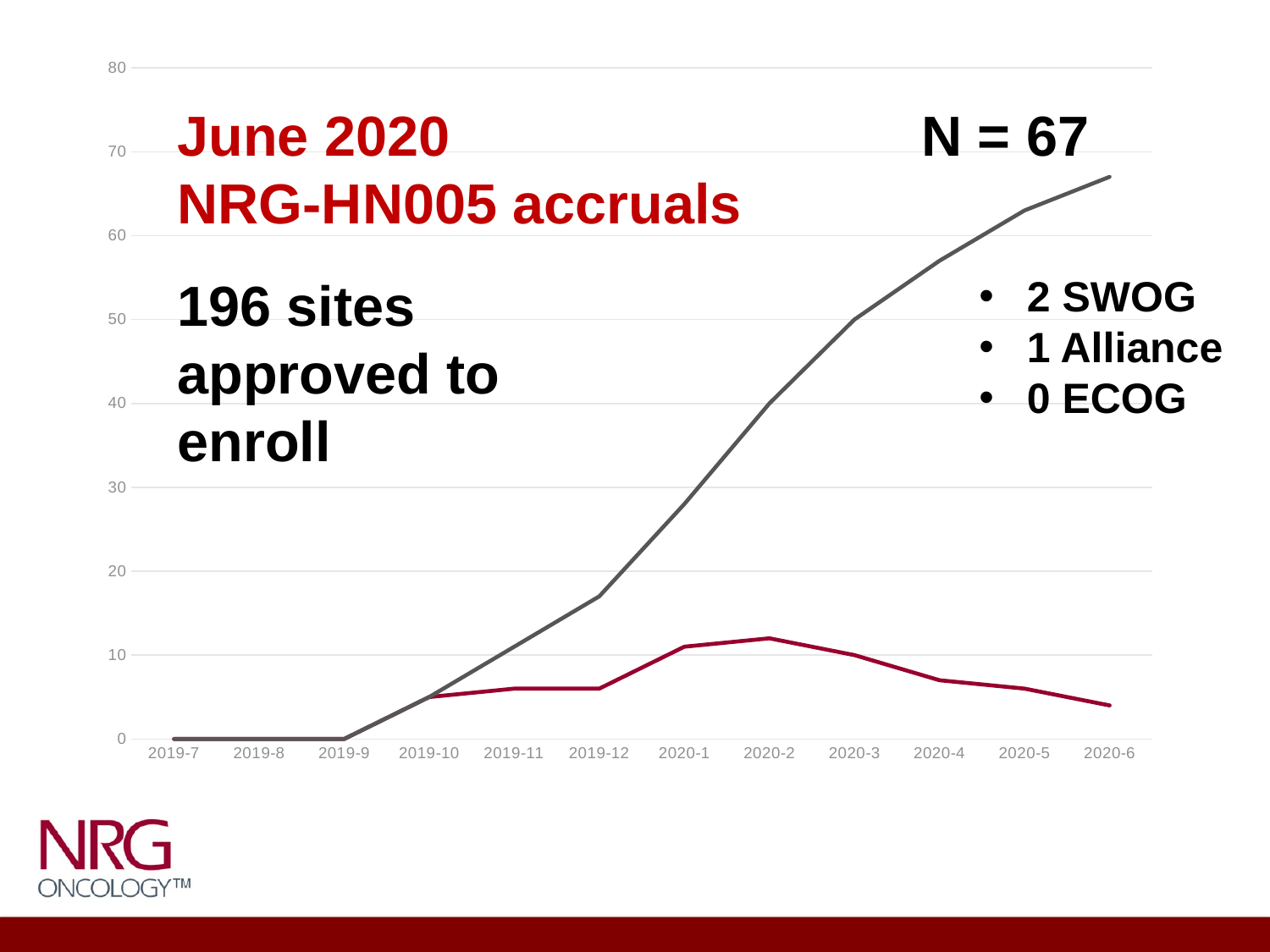
At which month does the gray line reach its highest point? 2020-6 Is the value of the gray line at 2020-1 greater or less than 30? less At which month does the red line reach its highest point? 2020-2 What is the value of the gray line at 2019-9? 0 At 2020-6, which line has the larger value, the gray line or the red line? gray line What kind of chart is shown on the slide? line chart Is the value of the gray line at 2020-6 greater or less than 60? greater How many months are plotted along the x axis? 12 What is the value of the gray line at 2019-7? 0 Does the gray line rise or fall from 2019-9 to 2020-6? rise Is the value of the red line at 2020-6 greater or less than 10? less